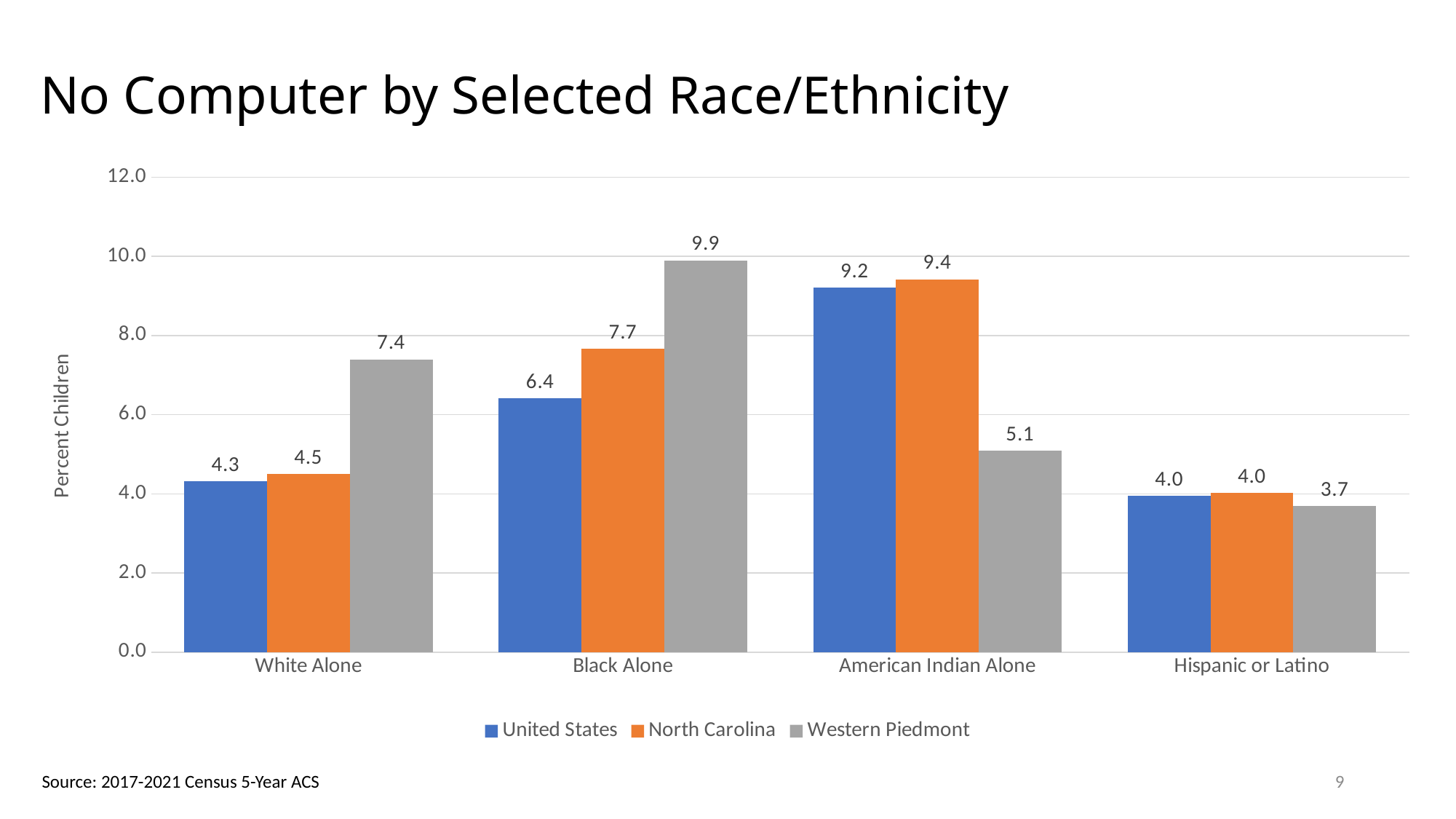
Which category has the lowest Western Piedmont value? Hispanic or Latino What is the North Carolina value for White Alone? 4.5 What is the United States value for American Indian Alone? 9.2 What is the label of the vertical axis? Percent Children How many race/ethnicity categories are shown on the x axis? 4 What is the Western Piedmont value for Black Alone? 9.9 How many series does the legend list? 3 Is the Western Piedmont value for Black Alone greater or less than 8.0? greater For American Indian Alone, which is larger: the North Carolina value or the Western Piedmont value? North Carolina What kind of chart is shown on the slide? Bar chart What is the difference between the Western Piedmont and United States values for White Alone? 3.1 Which category has the highest Western Piedmont value? Black Alone